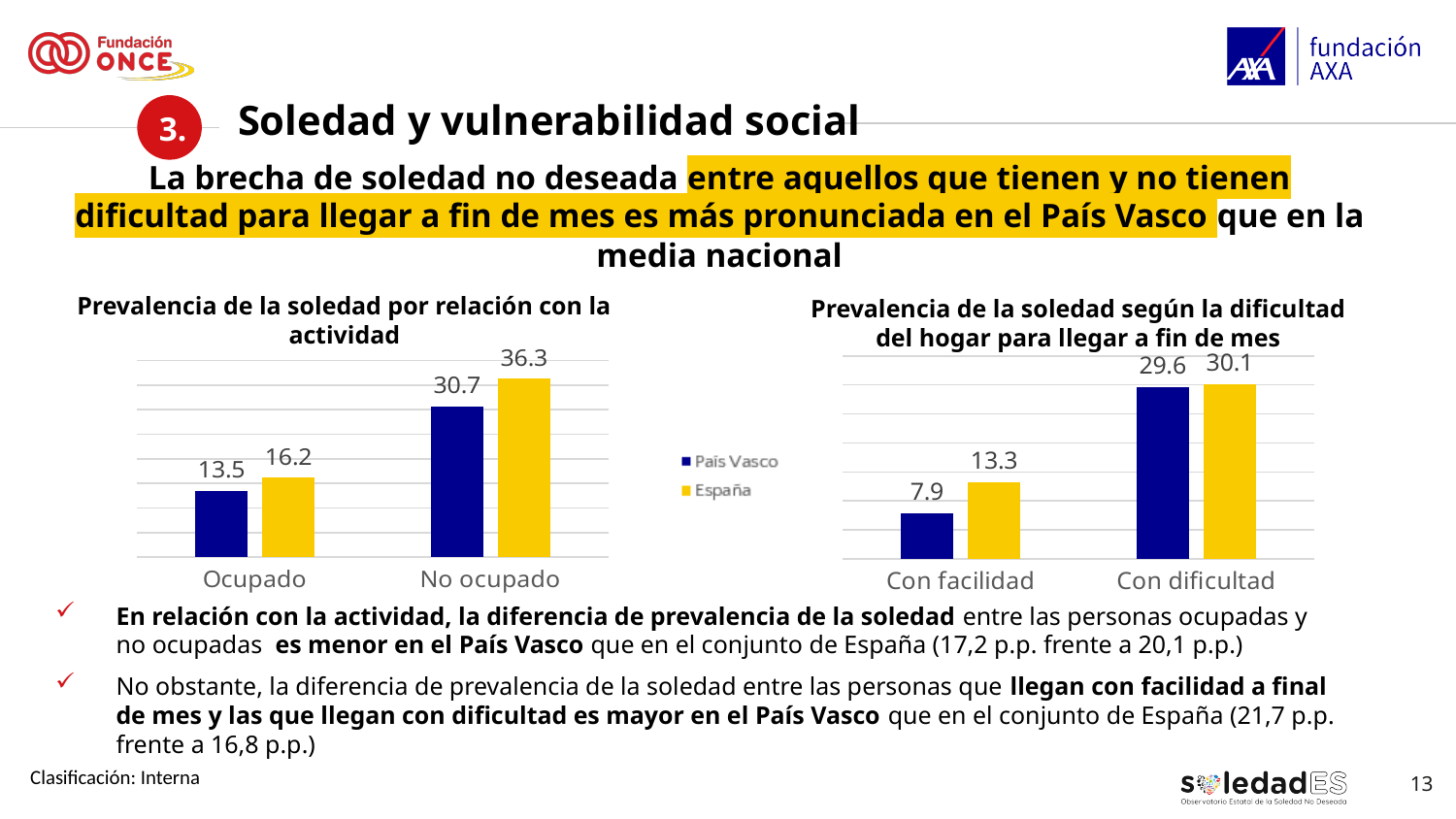
In the chart 'Prevalencia de la soledad según la dificultad del hogar para llegar a fin de mes', what is the value for España in the Con dificultad category? 30.1 In the chart 'Prevalencia de la soledad según la dificultad del hogar para llegar a fin de mes', which category has the lowest value for País Vasco? Con facilidad In the chart 'Prevalencia de la soledad por relación con la actividad', what is the difference between the España and País Vasco values for No ocupado? 5.6 In the chart 'Prevalencia de la soledad por relación con la actividad', what is the value for España in the No ocupado category? 36.3 In the chart 'Prevalencia de la soledad por relación con la actividad', which category has the highest value for España? No ocupado In the chart 'Prevalencia de la soledad según la dificultad del hogar para llegar a fin de mes', what is the difference between the España and País Vasco values for Con facilidad? 5.4 In the chart 'Prevalencia de la soledad por relación con la actividad', which is larger for Ocupado: the País Vasco value or the España value? España How many categories are shown in the chart 'Prevalencia de la soledad según la dificultad del hogar para llegar a fin de mes'? 2 What type of chart is 'Prevalencia de la soledad por relación con la actividad'? Bar chart In the chart 'Prevalencia de la soledad por relación con la actividad', what is the value for País Vasco in the Ocupado category? 13.5 In the chart 'Prevalencia de la soledad según la dificultad del hogar para llegar a fin de mes', what is the value for País Vasco in the Con facilidad category? 7.9 How many series does the legend list for the charts on the slide? 2